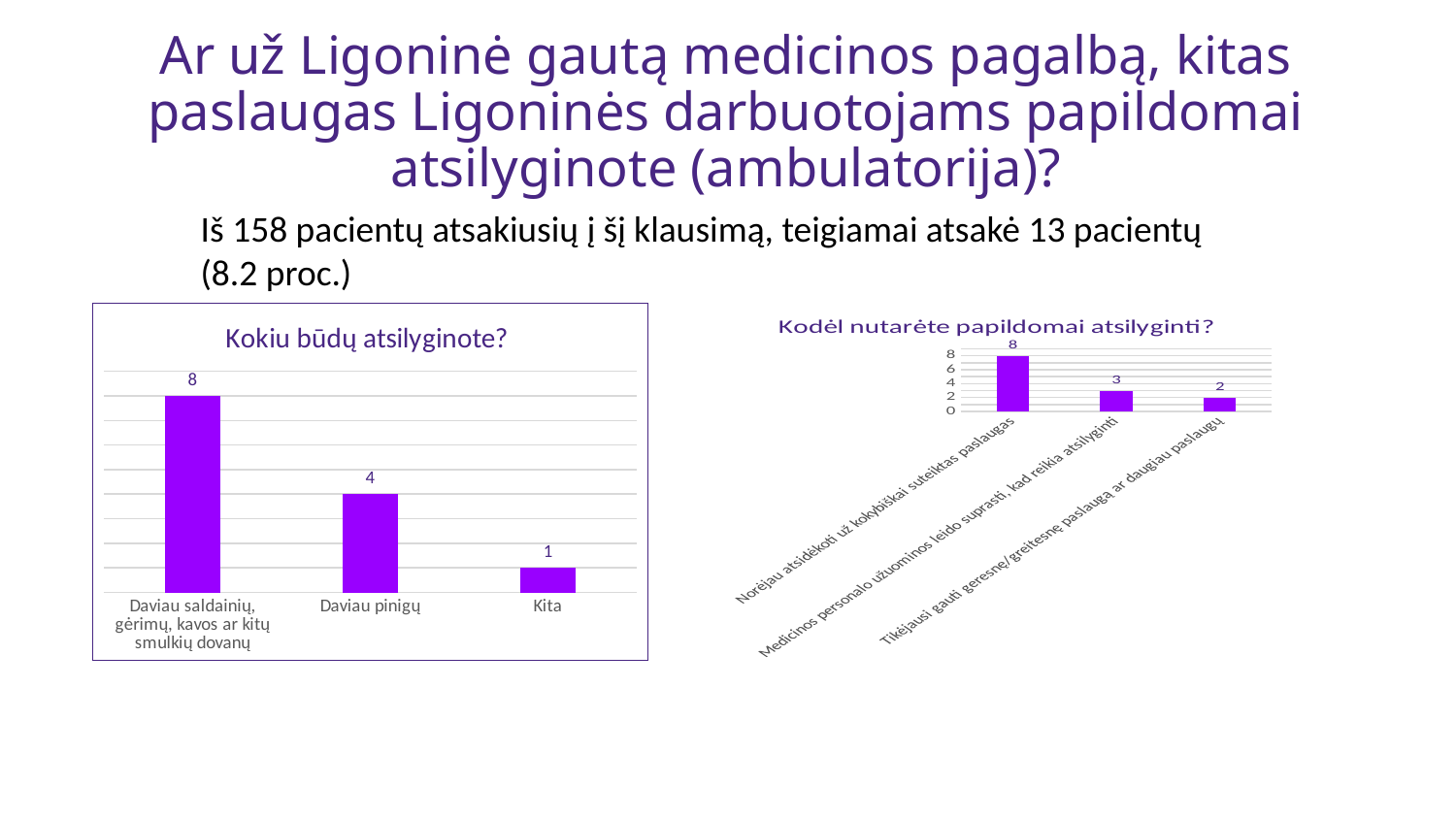
In the chart titled "Kodėl nutarėte papildomai atsilyginti?", do the values rise or fall from left to right along the x axis? Fall In the chart titled "Kokiu būdų atsilyginote?", what is the value for "Daviau pinigų"? 4 In the chart titled "Kokiu būdų atsilyginote?", which category has the highest value? Daviau saldainių, gėrimų, kavos ar kitų smulkių dovanų In the chart titled "Kodėl nutarėte papildomai atsilyginti?", which is larger: the value for "Medicinos personalo užuominos leido suprasti, kad reikia atsilyginti" or the value for "Tikėjausi gauti geresnę/greitesnę paslaugą ar daugiau paslaugų"? Medicinos personalo užuominos leido suprasti, kad reikia atsilyginti In the chart titled "Kokiu būdų atsilyginote?", which category has the lowest value? Kita In the chart titled "Kokiu būdų atsilyginote?", how many categories are shown? 3 In the chart titled "Kodėl nutarėte papildomai atsilyginti?", what is the value for "Tikėjausi gauti geresnę/greitesnę paslaugą ar daugiau paslaugų"? 2 What kind of chart is the chart titled "Kokiu būdų atsilyginote?"? Bar chart In the chart titled "Kodėl nutarėte papildomai atsilyginti?", what is the value for "Norėjau atsidėkoti už kokybiškai suteiktas paslaugas"? 8 In the chart titled "Kokiu būdų atsilyginote?", what is the value for "Kita"? 1 In the chart titled "Kodėl nutarėte papildomai atsilyginti?", what is the difference between the values for "Norėjau atsidėkoti už kokybiškai suteiktas paslaugas" and "Medicinos personalo užuominos leido suprasti, kad reikia atsilyginti"? 5 In the chart titled "Kokiu būdų atsilyginote?", what is the difference between the values for "Daviau saldainių, gėrimų, kavos ar kitų smulkių dovanų" and "Daviau pinigų"? 4